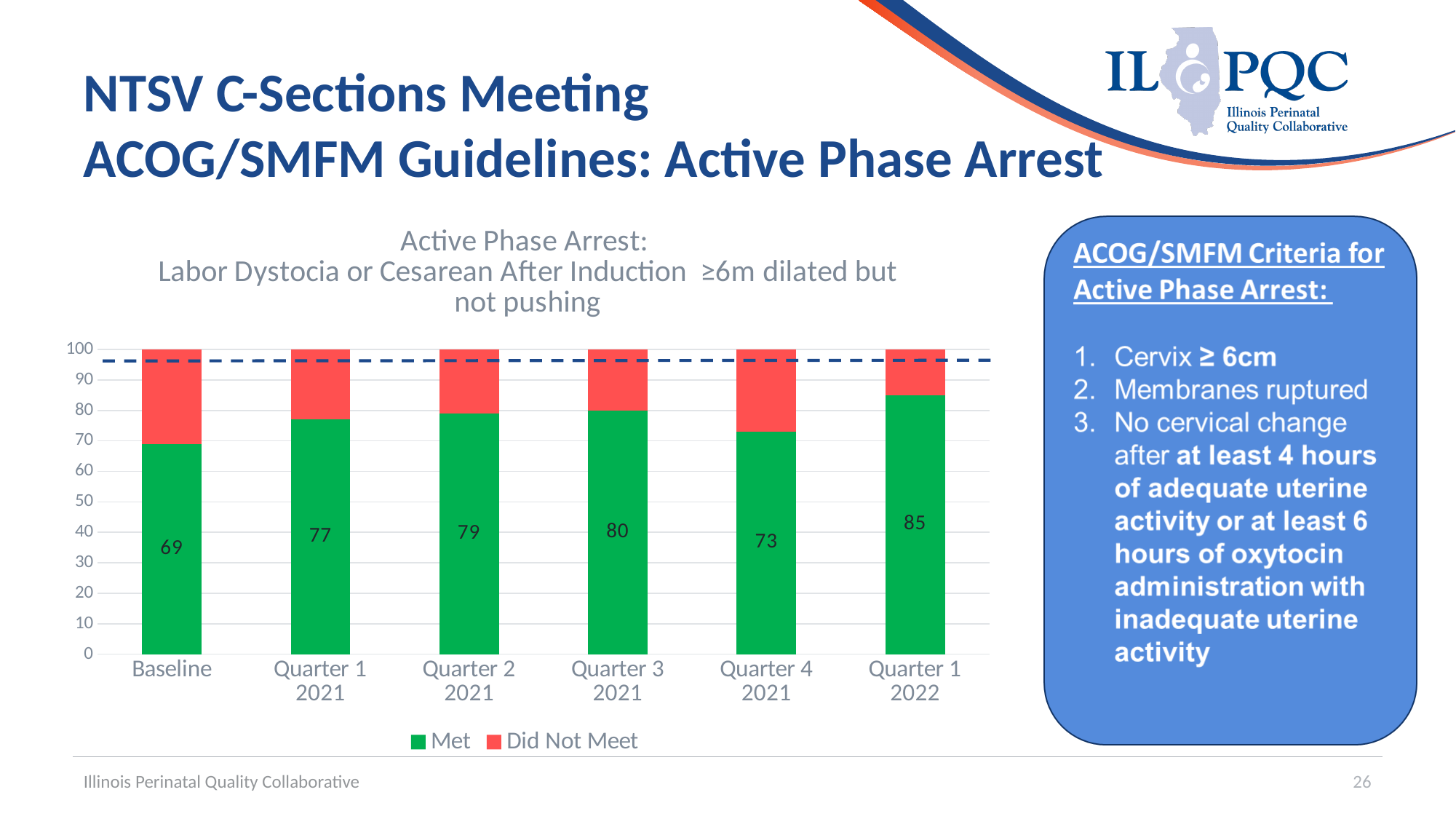
How many series does the legend list? 2 What is the Met value for Quarter 4 2021? 73 Which category has the highest Met value? Quarter 1 2022 Is the Did Not Meet value for Baseline greater or less than 20? greater Which category has the lowest Met value? Baseline Which has a larger Met value, Quarter 3 2021 or Quarter 4 2021? Quarter 3 2021 What is the Met value for Baseline? 69 What is the difference between the Met value for Quarter 1 2022 and the Met value for Baseline? 16 How many categories are shown on the x axis? 6 Which colour represents the Did Not Meet series? red What kind of chart is shown on the slide? stacked bar chart What is the Met value for Quarter 1 2022? 85